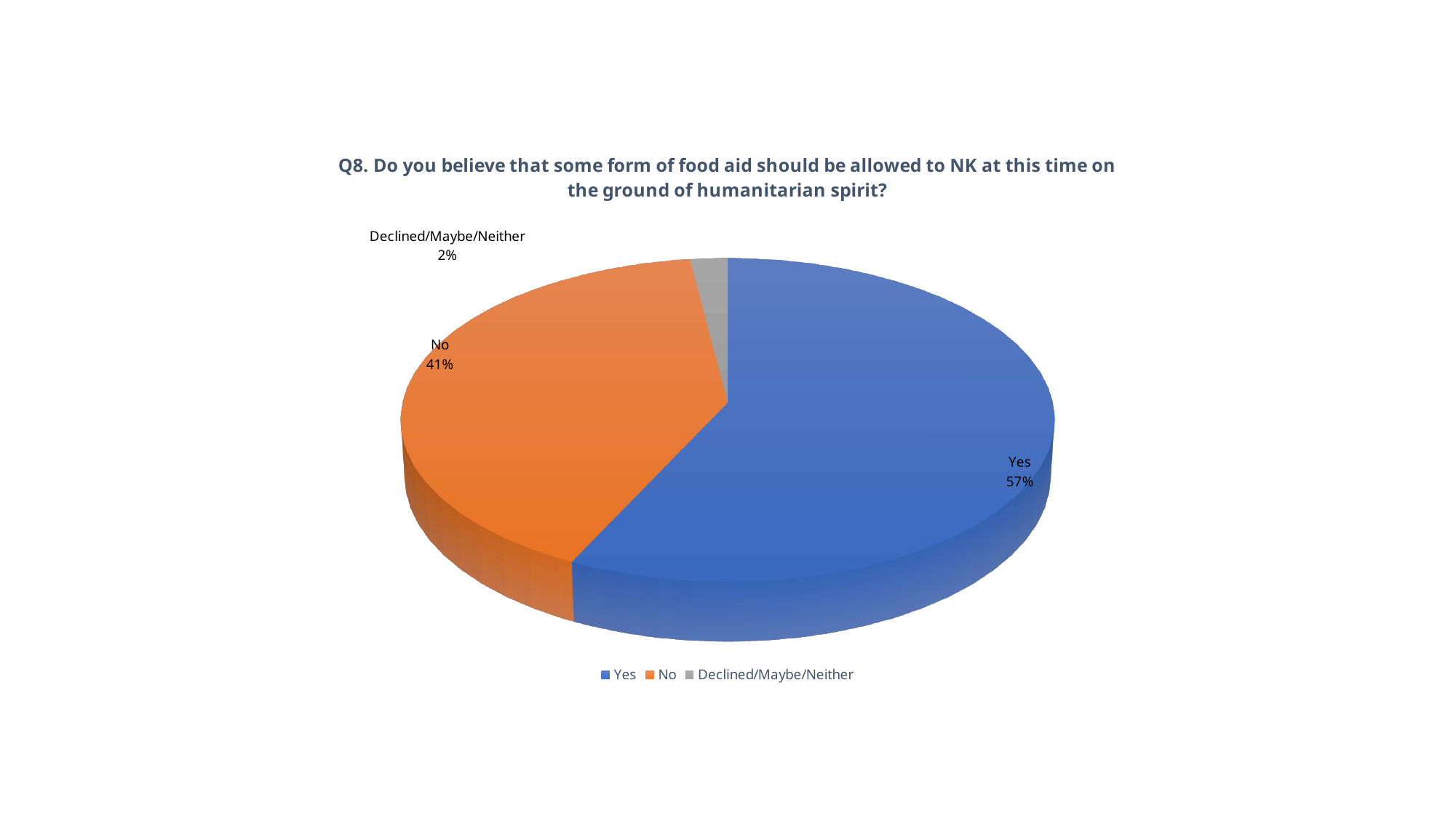
Which response has the smallest share of the pie? Declined/Maybe/Neither What colour is the No slice? Orange Which is larger, the share for No or the share for Declined/Maybe/Neither? No How many categories are shown in the pie chart? 3 Which response has the largest share of the pie? Yes What percentage of respondents answered No? 41% What kind of chart is shown on the slide? Pie chart How many entries does the legend list? 3 What is the difference in percentage points between the Yes and No shares? 16 What percentage of respondents answered Yes? 57% What share of the pie does the Yes slice represent? 57% What percentage of respondents are in the Declined/Maybe/Neither category? 2%